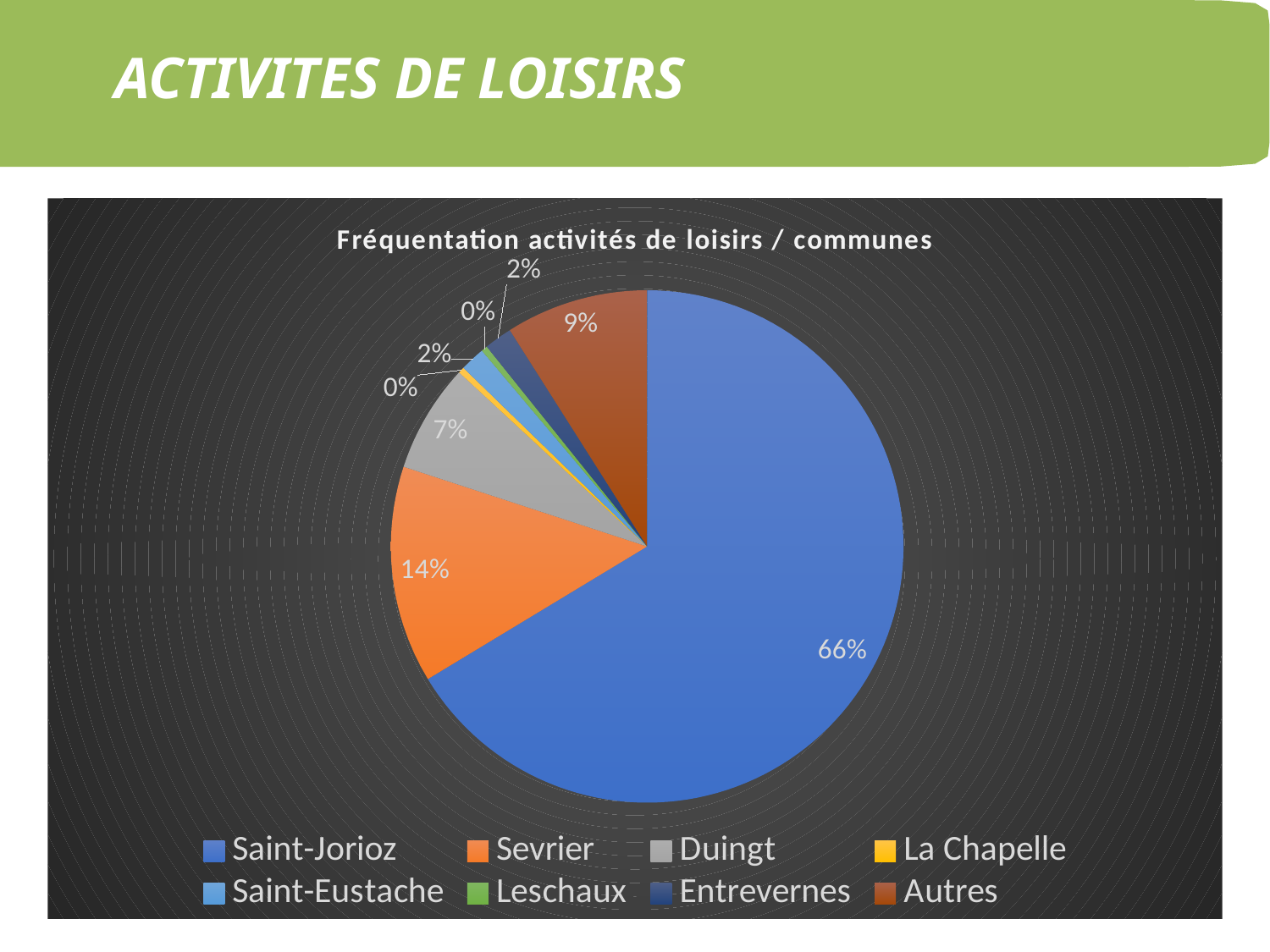
What percentage is shown for Duingt? 7% What type of chart is shown on the slide? Pie chart What percentage is shown for Autres? 9% What colour is the slice for Sevrier? Orange What share of the pie does Saint-Jorioz represent? 66% What is the difference in percentage points between Saint-Jorioz and Sevrier? 52 percentage points Which commune has the largest slice of the pie? Saint-Jorioz Which is larger, the slice for Sevrier or the slice for Autres? Sevrier Which is larger, the slice for Duingt or the slice for Autres? Autres What is the title of the chart? Fréquentation activités de loisirs / communes How many communes/categories are listed in the legend? 8 What percentage is shown for Sevrier? 14%